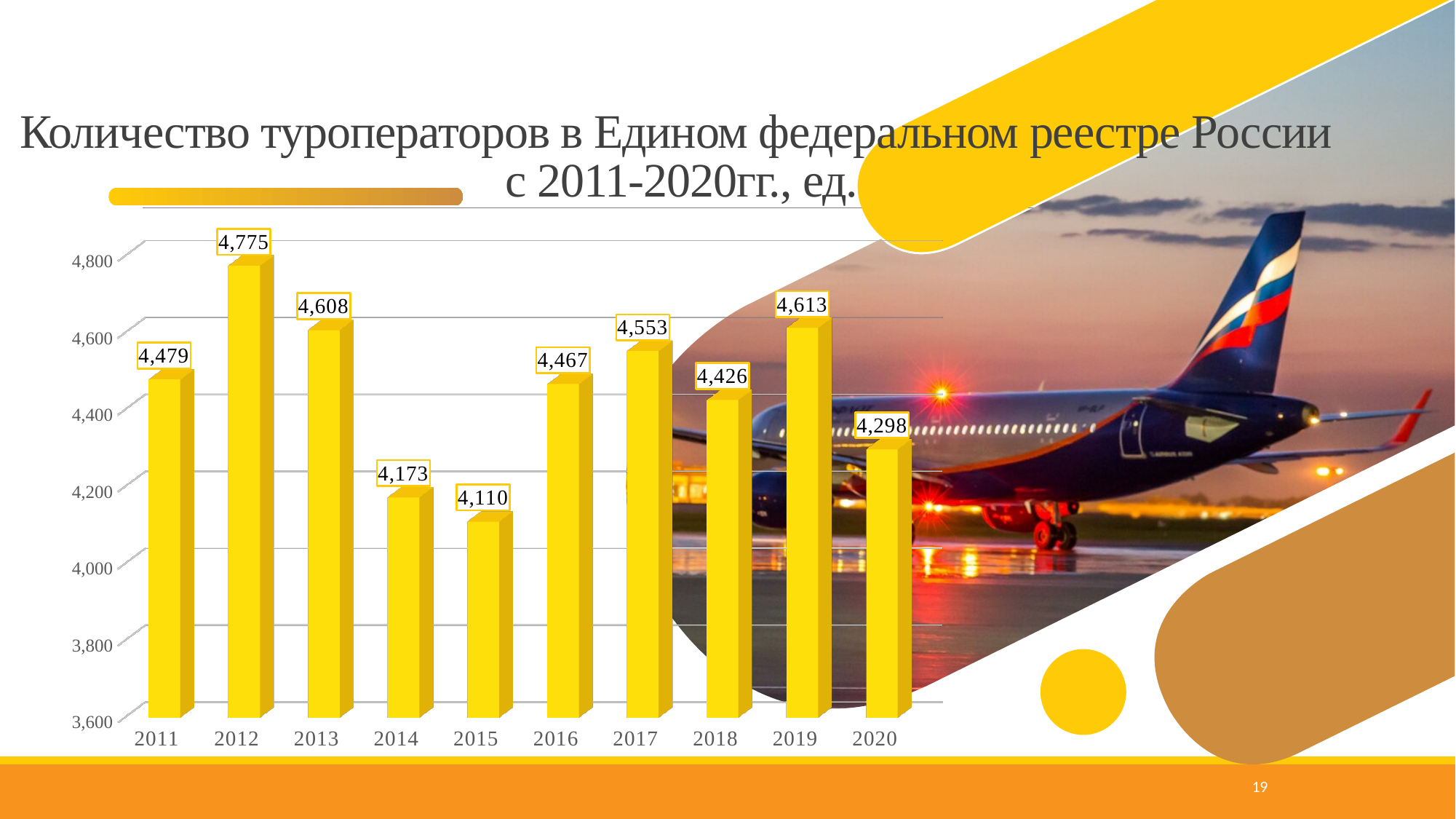
What is the value for 2012? 4,775 Do the values rise or fall from 2012 to 2015? fall Which is larger, the value for 2013 or the value for 2019? 2019 What is the difference between the values for 2012 and 2015? 665 Is the value for 2014 greater or less than 4,200? less What is the value for 2015? 4,110 Which year has the lowest value? 2015 What kind of chart is shown on the slide? bar chart What is the difference between the values for 2019 and 2020? 315 How many years are shown on the x axis? 10 What is the value for 2020? 4,298 Which year has the highest value? 2012